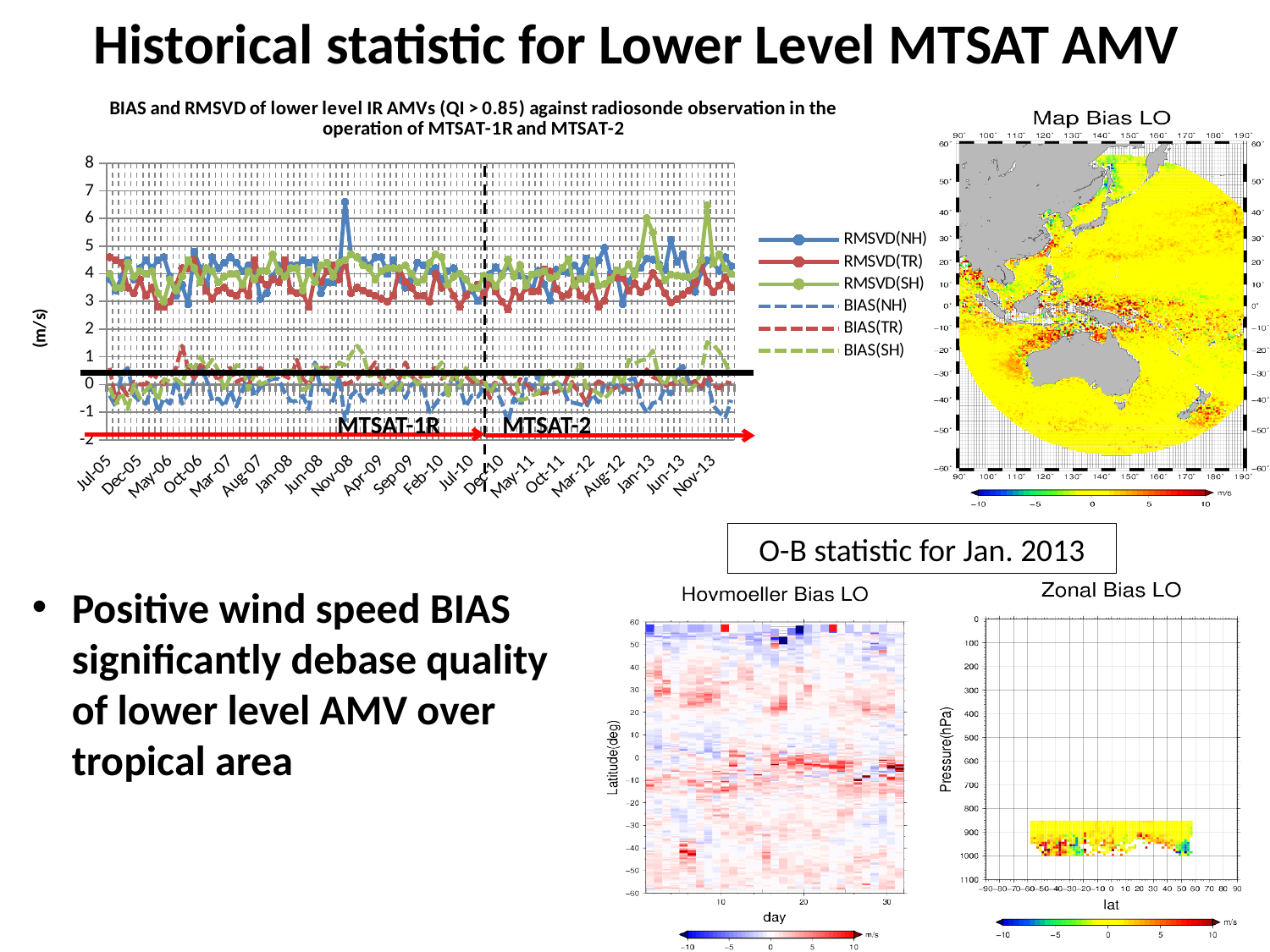
In the 'BIAS and RMSVD of lower level IR AMVs' line chart, which two satellite periods are labelled along the x axis? MTSAT-1R and MTSAT-2 In the 'BIAS and RMSVD of lower level IR AMVs' line chart, is the RMSVD(TR) value at Jul-05 greater or less than 3? greater In the 'BIAS and RMSVD of lower level IR AMVs' line chart, which is larger at Nov-08: RMSVD(NH) or RMSVD(TR)? RMSVD(NH) How many series does the legend of the 'BIAS and RMSVD of lower level IR AMVs' line chart list? 6 What is the x-axis label of the 'Hovmoeller Bias LO' chart? day In the 'BIAS and RMSVD of lower level IR AMVs' line chart, is the peak value of RMSVD(NH) near Nov-08 greater or less than 6? greater In the 'BIAS and RMSVD of lower level IR AMVs' line chart, which is larger at Jul-05: RMSVD(TR) or BIAS(TR)? RMSVD(TR) What is the title of the chart in the bottom right corner of the slide? Zonal Bias LO In the 'BIAS and RMSVD of lower level IR AMVs' line chart, is the BIAS(TR) value at Jul-05 greater or less than 2? less What kind of chart is the 'BIAS and RMSVD of lower level IR AMVs' chart on the left of the slide? line chart What unit is shown on the y axis of the 'BIAS and RMSVD of lower level IR AMVs' line chart? (m/s) What is the title of the map chart in the top right of the slide? Map Bias LO